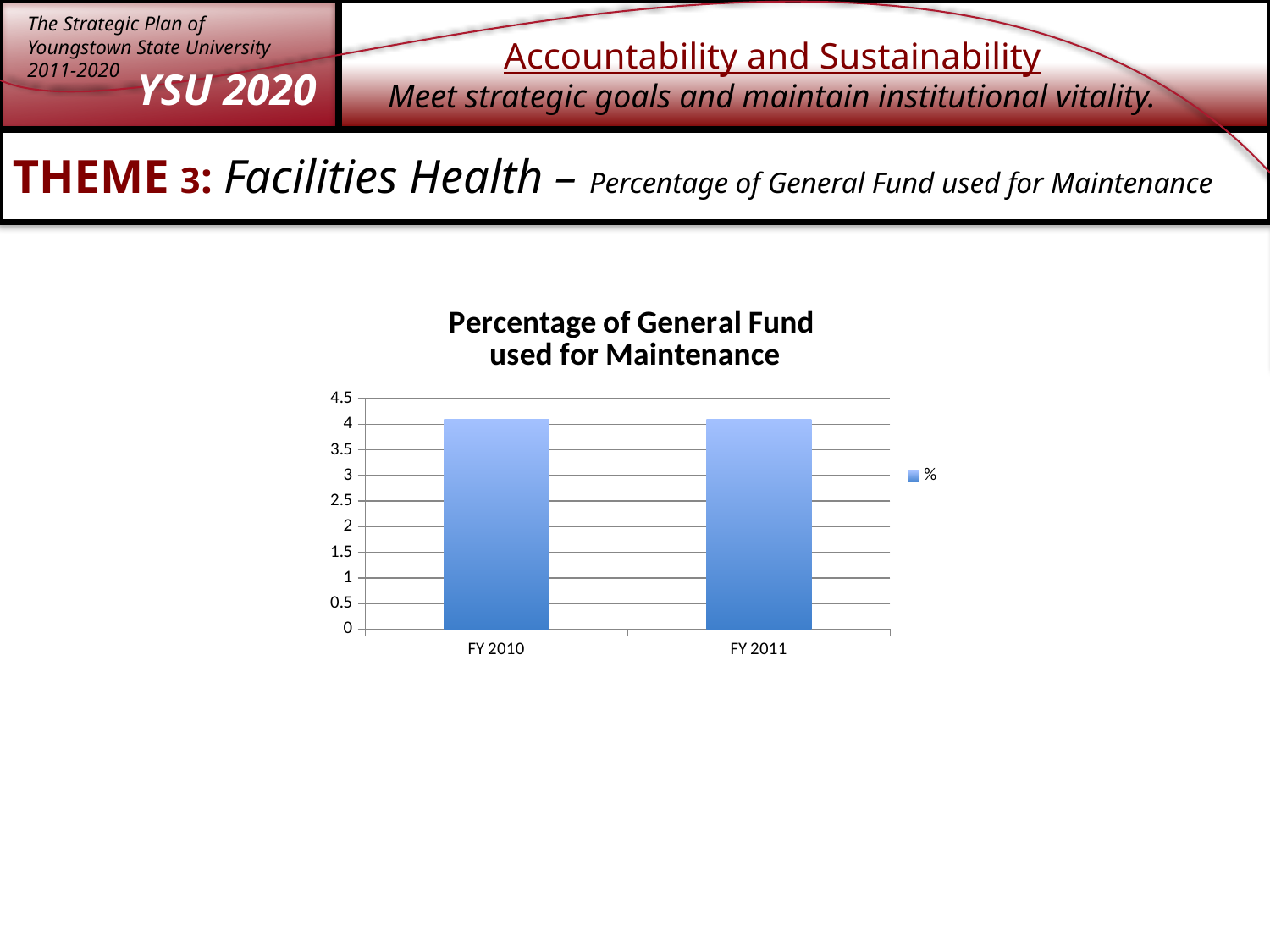
Is the value for FY 2010 greater or less than 4.5? less What is the title of the chart? Percentage of General Fund used for Maintenance What is the highest value shown on the chart's vertical axis? 4.5 How many series does the chart's legend list? 1 What kind of chart is shown on the slide? bar chart How many fiscal years are shown on the x axis of the chart? 2 What label does the chart's legend show for the series? % Is the value for FY 2011 greater or less than 3? greater Is the value for FY 2011 greater or less than 3.5? greater